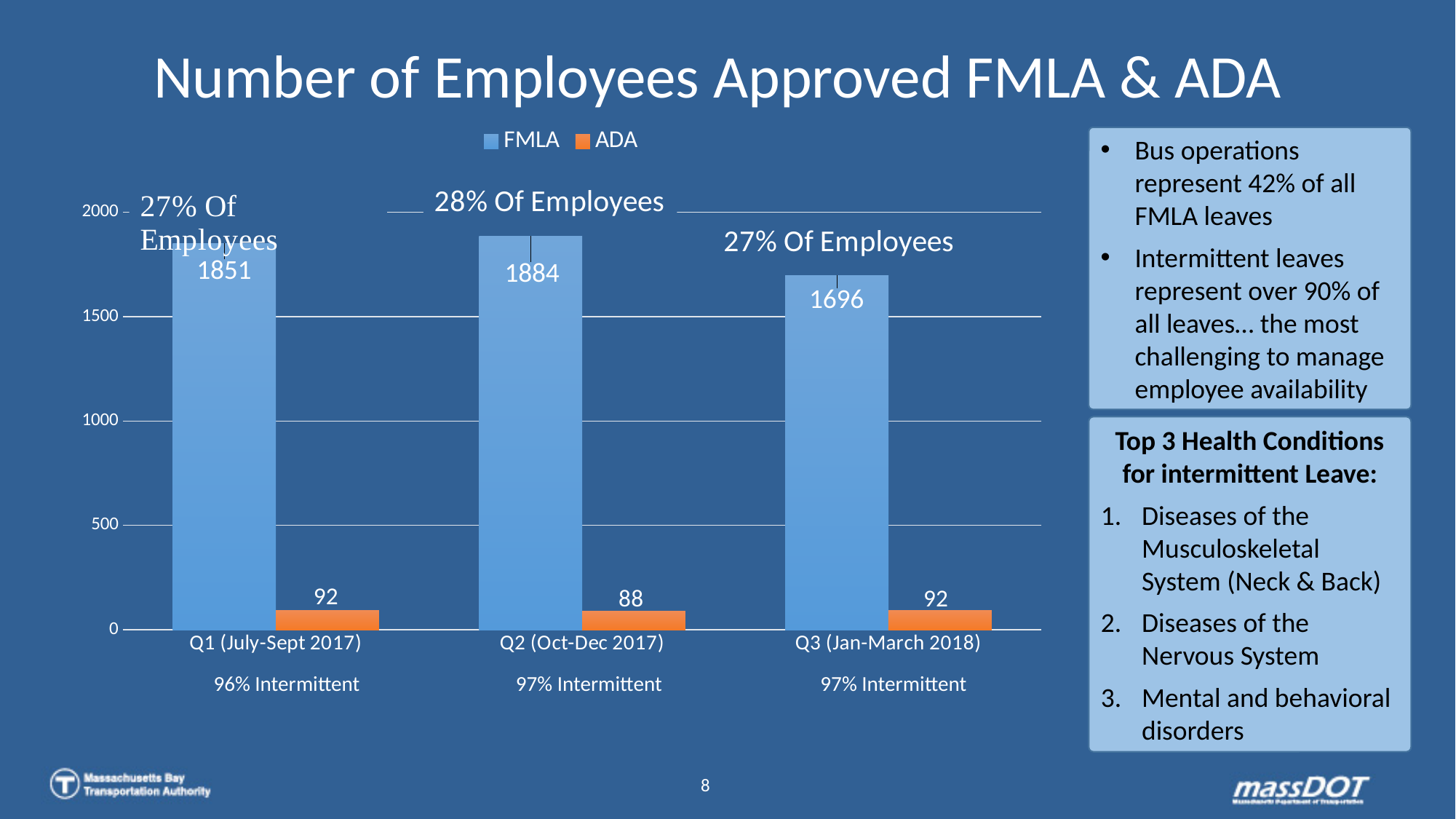
Which quarter has the highest FMLA value? Q2 (Oct-Dec 2017) What is the title of the chart? Number of Employees Approved FMLA & ADA What is the ADA value for Q3 (Jan-March 2018)? 92 Which is larger, the FMLA value for Q1 (July-Sept 2017) or for Q3 (Jan-March 2018)? Q1 (July-Sept 2017) What kind of chart is shown? bar chart How many series does the legend list? 2 How many quarters are shown on the x axis? 3 Is the FMLA value for Q3 (Jan-March 2018) greater or less than 1500? greater What is the difference between the FMLA values for Q2 (Oct-Dec 2017) and Q3 (Jan-March 2018)? 188 Which quarter has the lowest ADA value? Q2 (Oct-Dec 2017) What is the FMLA value for Q2 (Oct-Dec 2017)? 1884 What is the FMLA value for Q1 (July-Sept 2017)? 1851